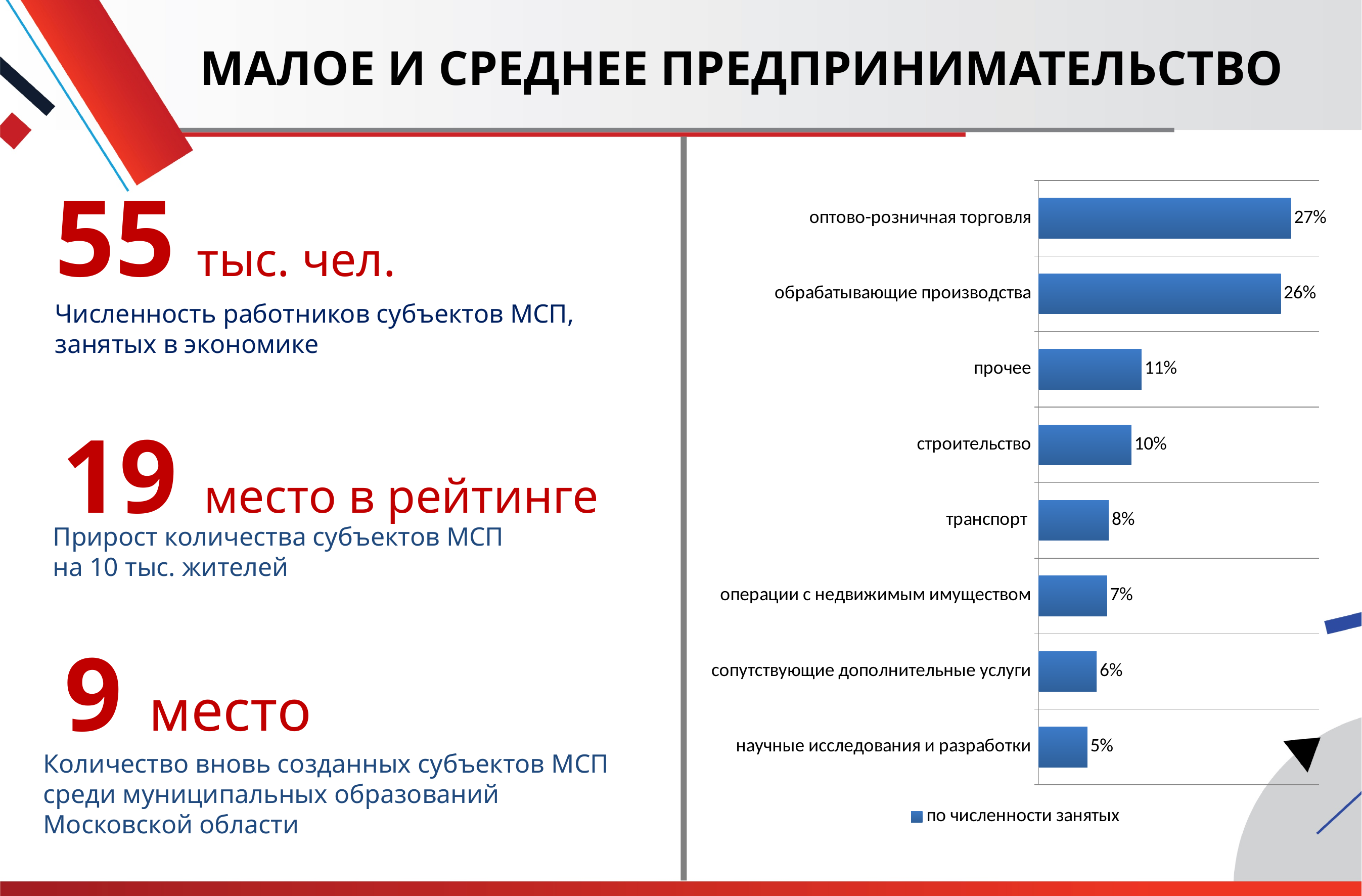
What is the difference between the values for транспорт and сопутствующие дополнительные услуги? 2% Which category has the highest value? оптово-розничная торговля How many categories are shown in the chart? 8 What is the value for строительство? 10% Which category has the lowest value? научные исследования и разработки How many series does the legend list? 1 What is the value for научные исследования и разработки? 5% What is the difference between the values for оптово-розничная торговля and прочее? 16% What kind of chart is shown on the slide? bar chart What is the legend entry of the chart? по численности занятых Which is larger, the value for обрабатывающие производства or the value for строительство? обрабатывающие производства What is the value for оптово-розничная торговля? 27%